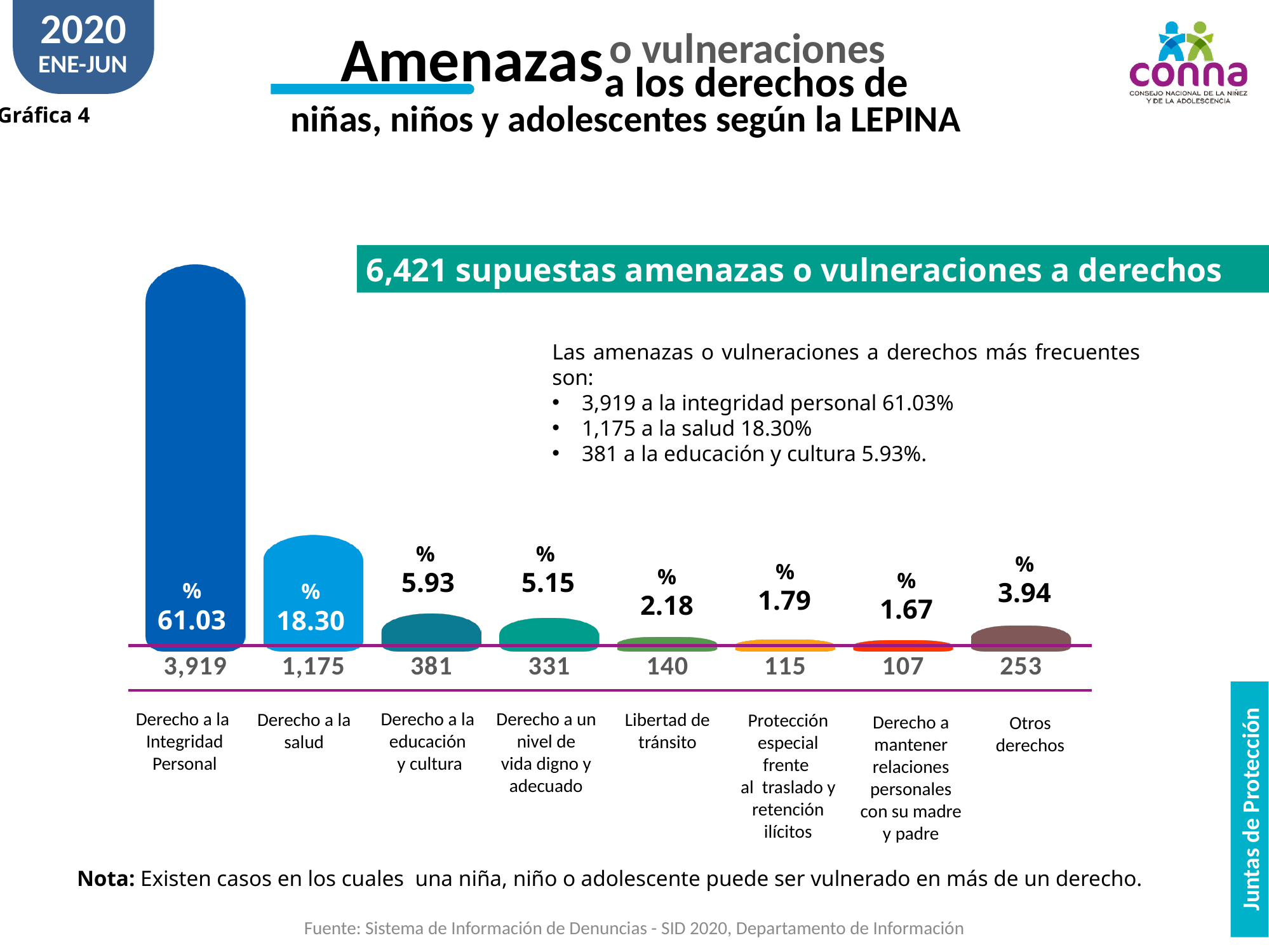
How many categories of rights are shown in the chart? 8 What is the difference between the counts for 'Protección especial frente al traslado y retención ilícitos' and 'Derecho a mantener relaciones personales con su madre y padre'? 8 What is the difference between the counts for 'Derecho a la Integridad Personal' and 'Derecho a la salud'? 2,744 What kind of chart is shown on the slide? Bar chart Which category has the highest number of alleged threats or violations? Derecho a la Integridad Personal What is the count shown for 'Libertad de tránsito'? 140 What percentage is shown for 'Derecho a la salud'? 18.30% How many alleged threats or violations to rights does the chart report for 'Derecho a la Integridad Personal'? 3,919 What percentage is shown for 'Otros derechos'? 3.94% Which has a larger count: 'Derecho a la educación y cultura' or 'Otros derechos'? Derecho a la educación y cultura Which category has the lowest number of alleged threats or violations? Derecho a mantener relaciones personales con su madre y padre What total number of alleged threats or violations to rights is stated on the slide? 6,421